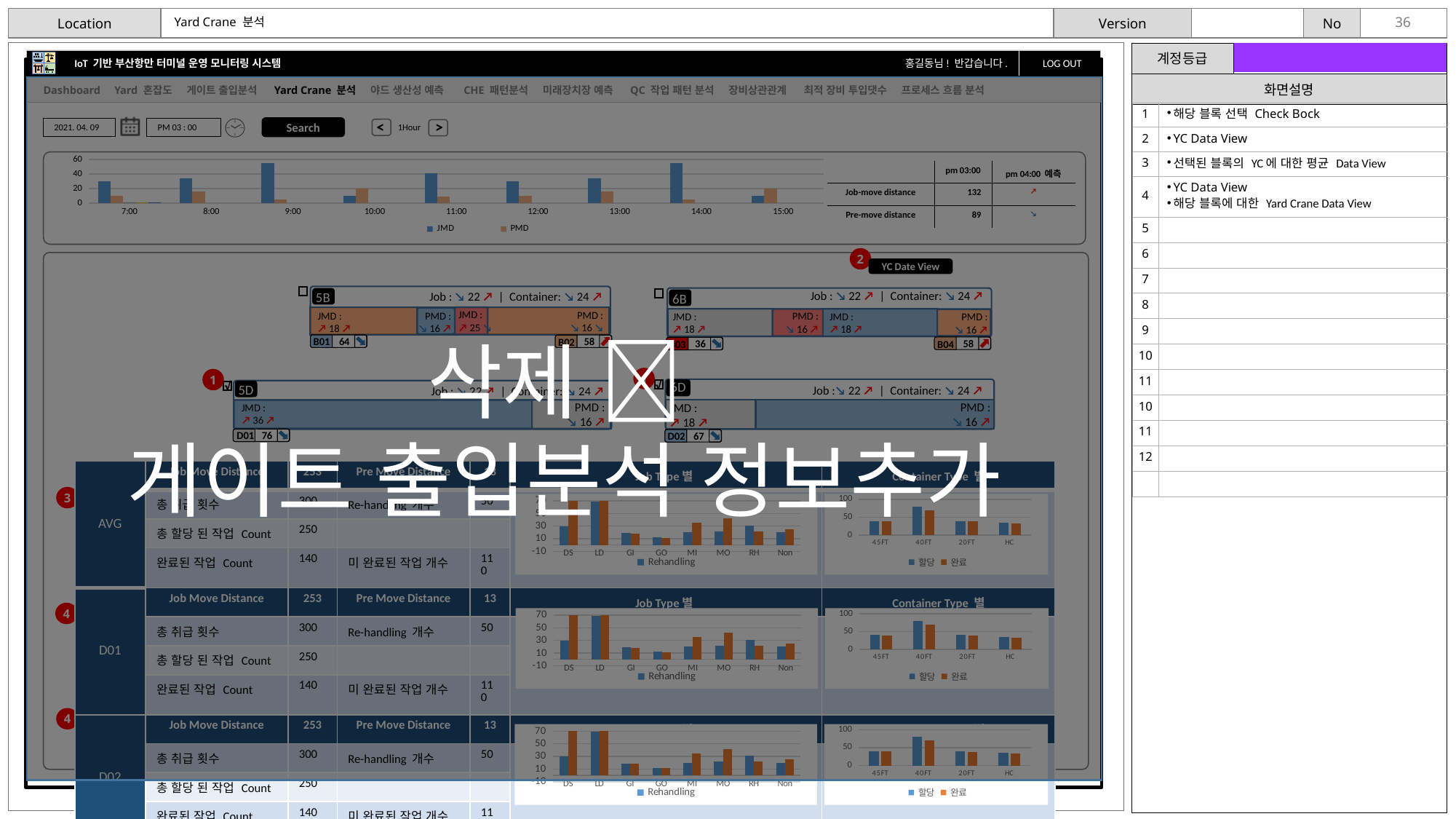
In the top JMD/PMD chart, is the JMD value at 9:00 greater or less than 40? greater In the top JMD/PMD chart, is the JMD value at 10:00 greater or less than 20? less How many series does the legend of the top JMD/PMD chart list? 2 In the Job Type 별 chart in the D01 row, how many job types are shown on the x axis? 8 What kind of chart is the JMD/PMD chart at the top of the dashboard? bar chart In the Job Type 별 chart in the D01 row, is the blue bar for LD greater or less than 50? greater In the Container Type 별 chart in the D01 row, how many series does the legend list? 2 In the Container Type 별 chart in the D01 row, which container type has the highest 할당 value? 40FT How many time categories are shown on the x axis of the top JMD/PMD chart? 9 In the Container Type 별 chart in the D01 row, how many container types are shown on the x axis? 4 In the top JMD/PMD chart, which series is shown in blue? JMD